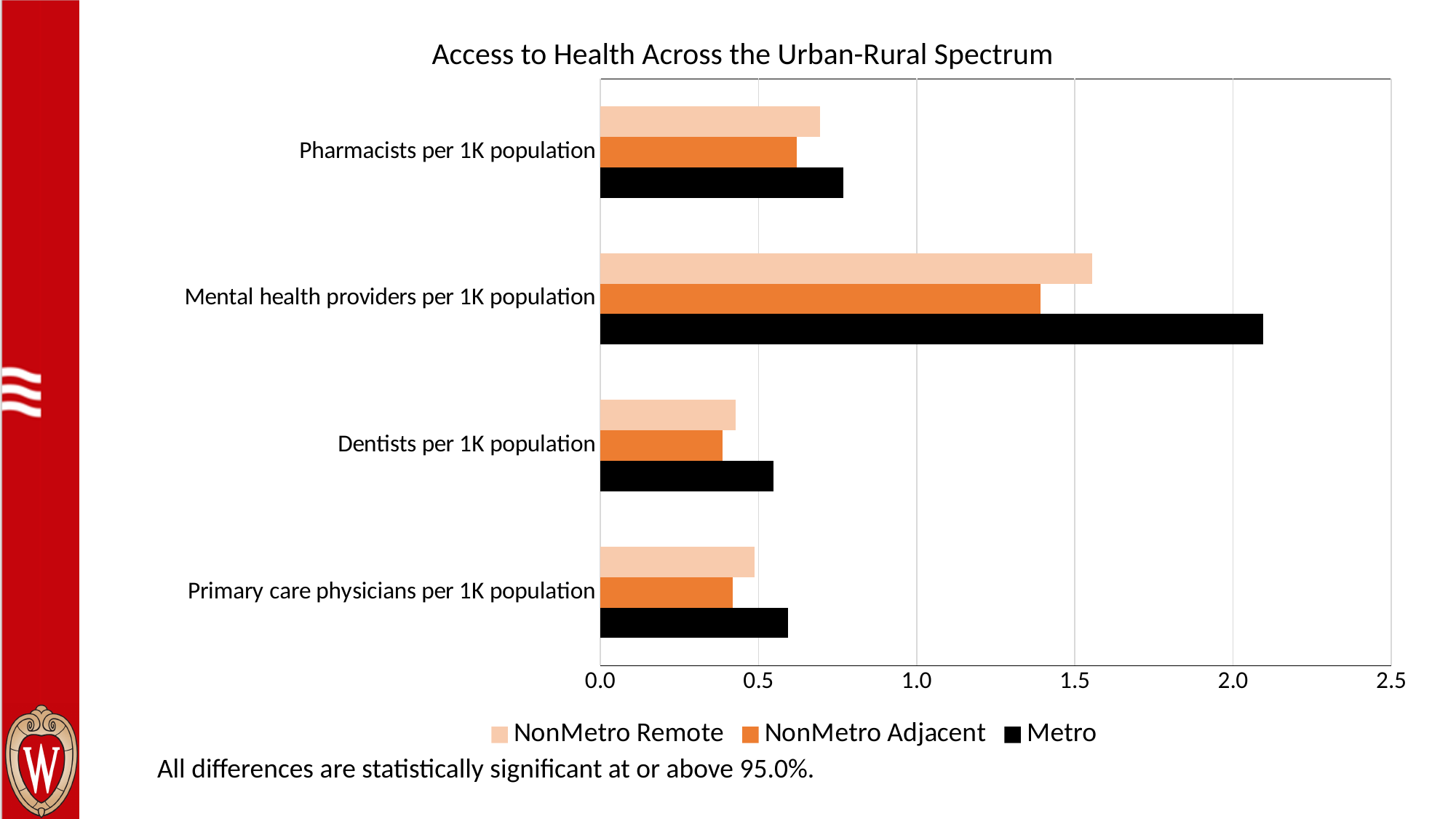
How many series does the legend list? 3 For Dentists per 1K population, which series has the lowest value? NonMetro Adjacent How many categories are plotted on the chart? 4 What kind of chart is shown on the slide? bar chart Which colour represents the Metro series in the legend? black For Pharmacists per 1K population, which is larger: the Metro value or the NonMetro Remote value? Metro Is the Metro value for Primary care physicians per 1K population greater or less than 0.5? greater Is the NonMetro Adjacent value for Mental health providers per 1K population greater or less than 1.5? less What is the title of the chart? Access to Health Across the Urban-Rural Spectrum Which category has the highest Metro value? Mental health providers per 1K population Is the Metro value for Mental health providers per 1K population greater or less than 2.0? greater For Mental health providers per 1K population, which series has the highest value? Metro